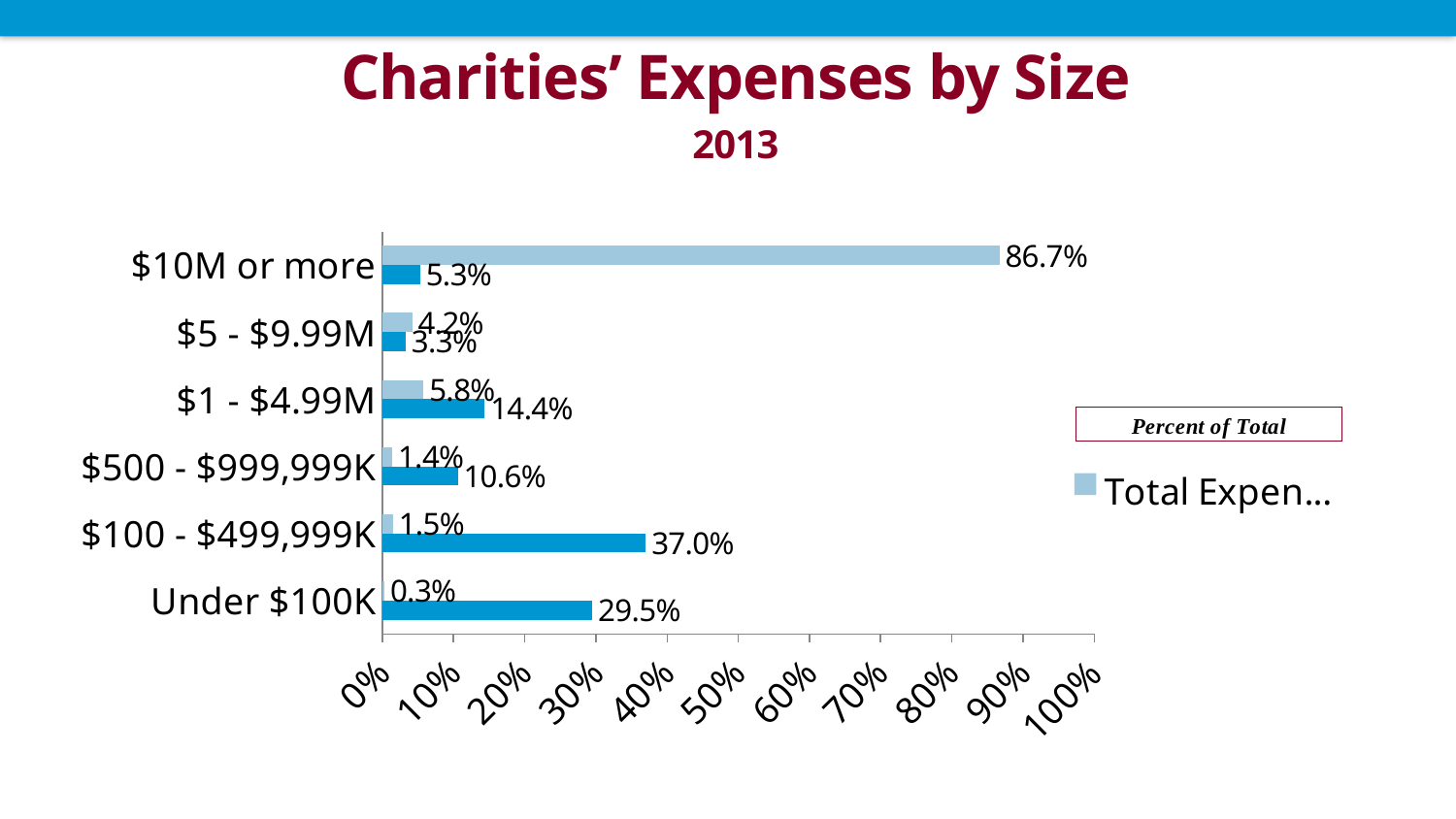
For the "$10M or more" category, what is the difference between the light blue bar (86.7%) and the dark blue bar (5.3%)? 81.4 percentage points Which category has the lowest value in the dark blue series? $5 - $9.99M Which category has the highest value in the dark blue series? $100 - $499,999K For the "$1 - $4.99M" category, which bar is larger, the light blue bar or the dark blue bar? the dark blue bar What is the value of the light blue bar for the "$10M or more" category? 86.7% What type of chart is shown on the slide? bar chart What is the value of the dark blue bar for the "$100 - $499,999K" category? 37.0% What year is shown in the subtitle of the chart? 2013 Which category has the lowest value in the light blue series? Under $100K Which category has the highest value in the light blue series? $10M or more What is the value of the dark blue bar for the "Under $100K" category? 29.5% How many size categories are shown on the y axis of the chart? 6